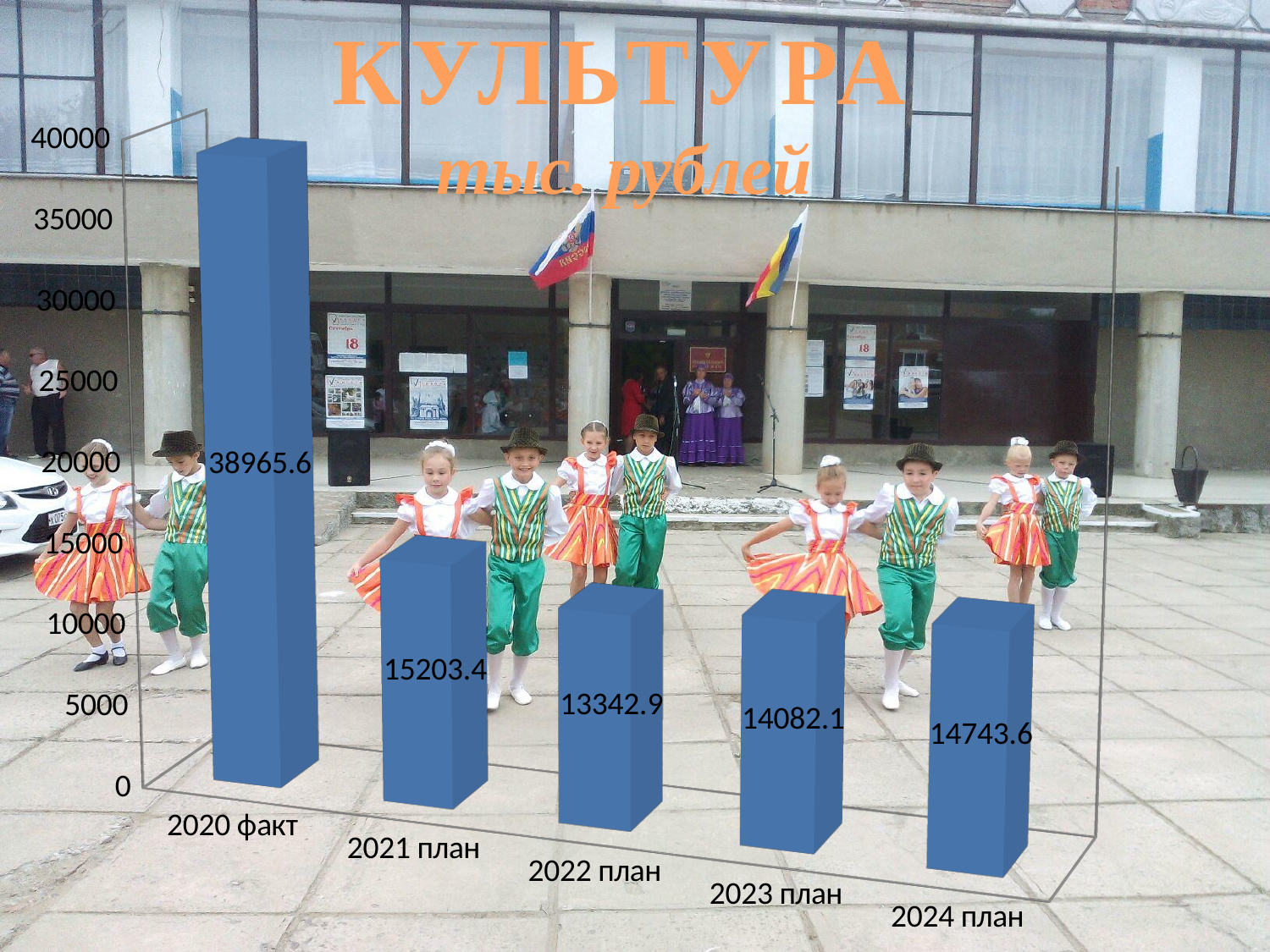
What is the difference between the values for 2020 факт and 2021 план? 23762.2 Which category has the highest value? 2020 факт What is the difference between the values for 2024 план and 2023 план? 661.5 What is the value for 2024 план? 14743.6 Do the values rise or fall from 2022 план to 2024 план? rise Which is larger, the value for 2021 план or the value for 2023 план? 2021 план What is the value for 2022 план? 13342.9 What is the value for 2020 факт? 38965.6 Is the value for 2023 план greater or less than 15000? less Which category has the lowest value? 2022 план How many categories are shown on the chart? 5 What kind of chart is shown on the slide? bar chart